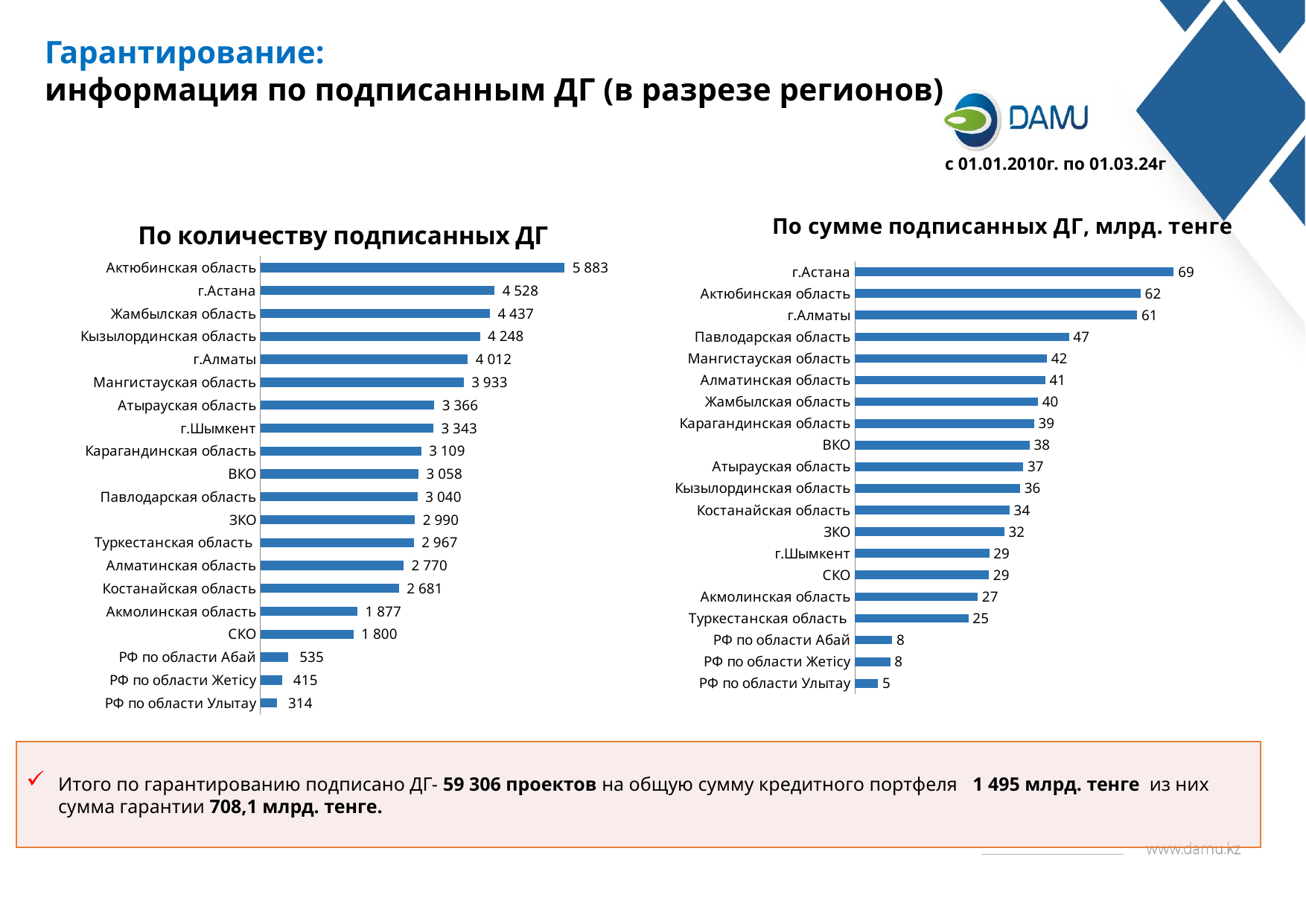
In the chart 'По количеству подписанных ДГ', what is the difference between the values for г.Астана and г.Алматы? 516 In the chart 'По количеству подписанных ДГ', which region has the lowest value? РФ по области Улытау In the chart 'По сумме подписанных ДГ, млрд. тенге', what is the value for Павлодарская область? 47 In the chart 'По сумме подписанных ДГ, млрд. тенге', which region has the highest value? г.Астана In the chart 'По количеству подписанных ДГ', which region has the highest value? Актюбинская область In the chart 'По количеству подписанных ДГ', what is the value for СКО? 1 800 In the chart 'По количеству подписанных ДГ', what is the value for Жамбылская область? 4 437 What kind of chart is 'По количеству подписанных ДГ'? Bar chart In the chart 'По сумме подписанных ДГ, млрд. тенге', which is larger: the value for ВКО or the value for ЗКО? ВКО In the chart 'По количеству подписанных ДГ', how many regions are shown? 20 In the chart 'По сумме подписанных ДГ, млрд. тенге', which region has the lowest value? РФ по области Улытау In the chart 'По сумме подписанных ДГ, млрд. тенге', what is the difference between the values for Актюбинская область and Туркестанская область? 37